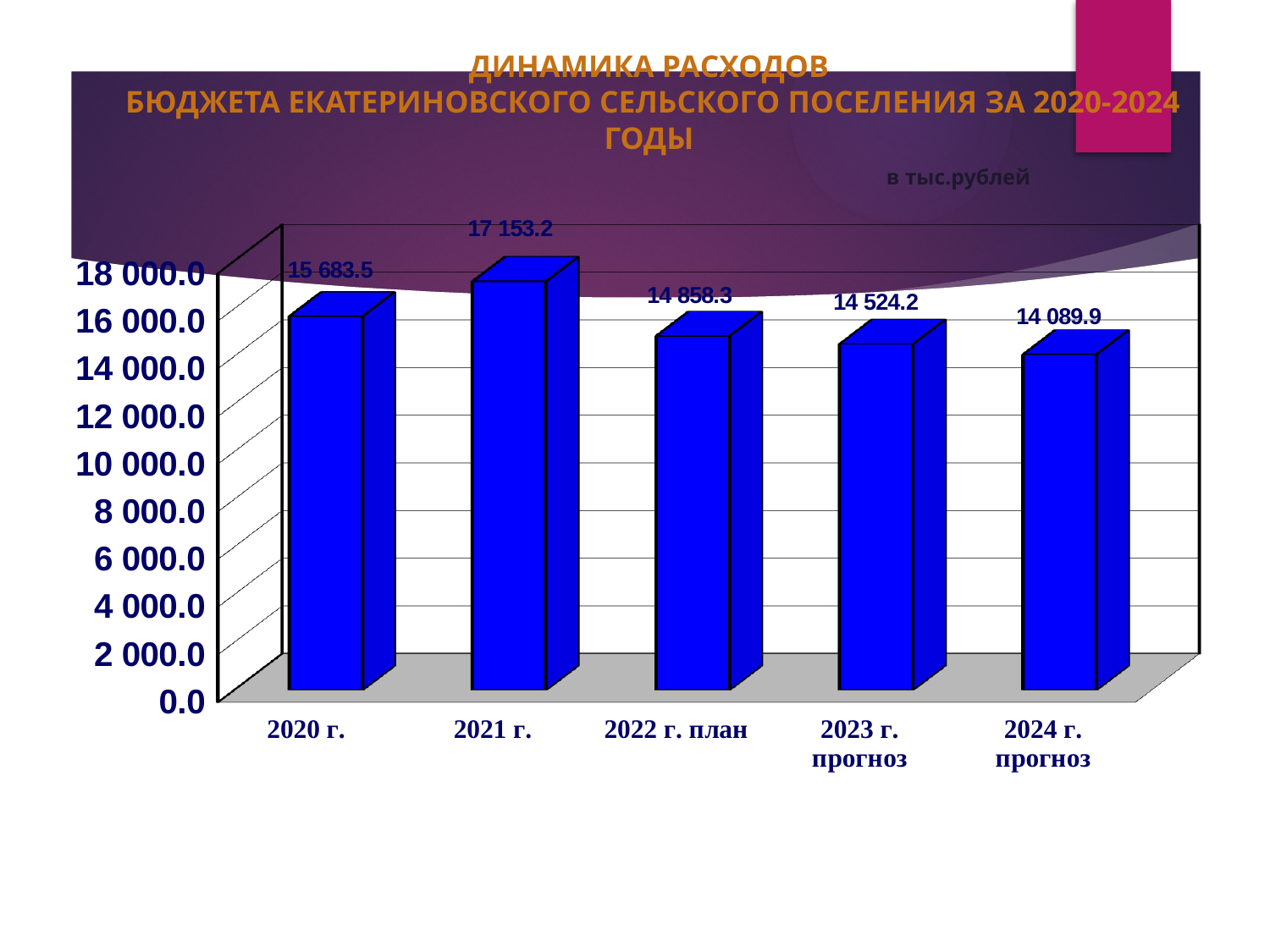
What is the value for 2022 г. план? 14 858.3 What kind of chart is shown on the slide? bar chart Which year has the lowest value? 2024 г. прогноз What is the difference between the values for 2023 г. прогноз and 2024 г. прогноз? 434.3 How many years (categories) are shown on the chart? 5 Is the value for 2021 г. greater or less than 16 000.0? greater Which year has the highest value? 2021 г. What is the difference between the values for 2021 г. and 2020 г.? 1 469.7 What is the value for 2024 г. прогноз? 14 089.9 What is the value for 2020 г.? 15 683.5 Do the values rise or fall from 2021 г. to 2024 г. прогноз? fall Which is larger, the value for 2022 г. план or the value for 2023 г. прогноз? 2022 г. план